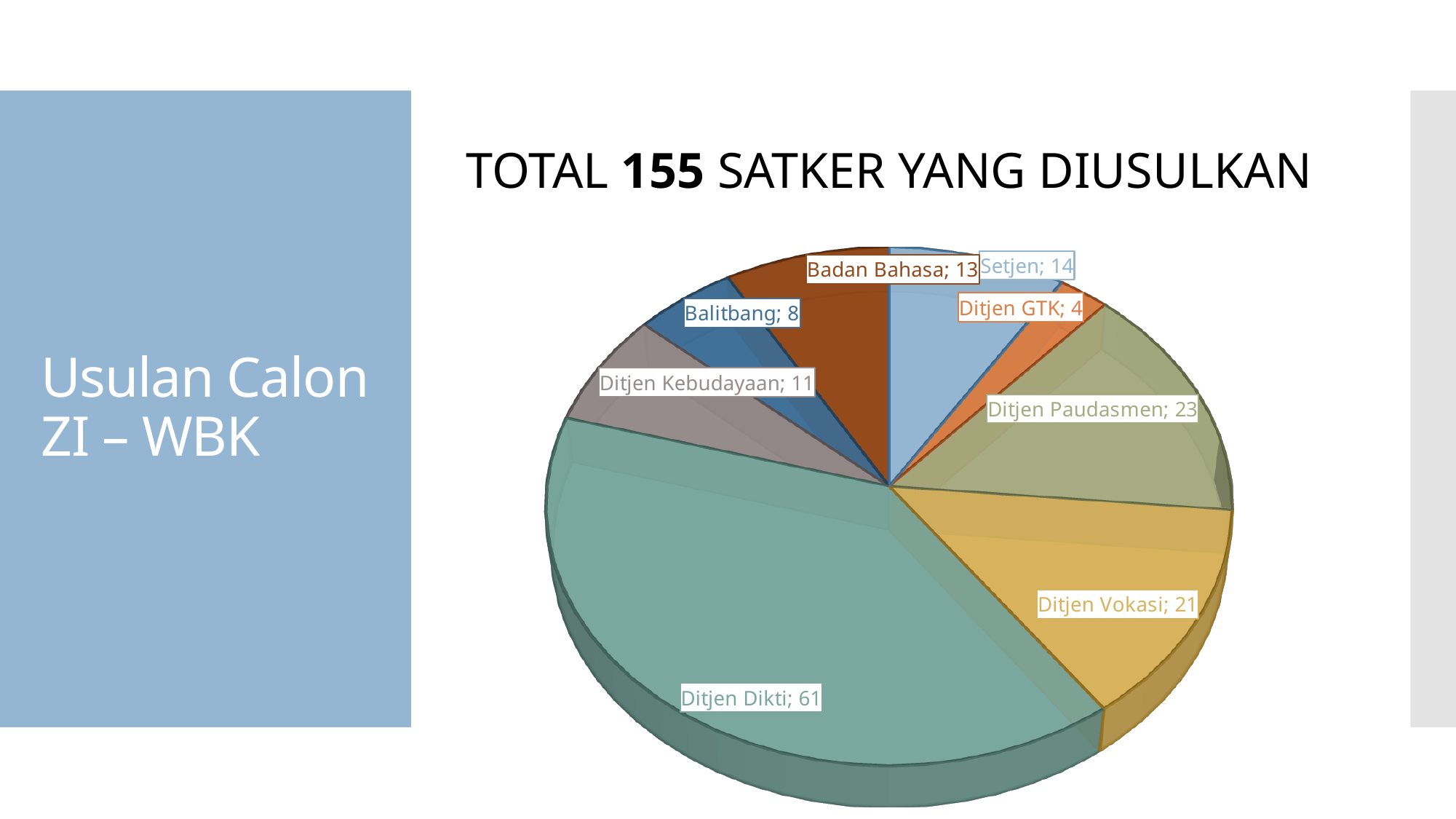
What is the value for Ditjen Dikti? 61 What is the difference between the values for Ditjen Paudasmen and Ditjen Vokasi? 2 What total number of satker does the chart title state? 155 Which is larger, the value for Ditjen Kebudayaan or the value for Balitbang? Ditjen Kebudayaan Which category has the smallest slice? Ditjen GTK What kind of chart is shown on the slide? pie chart What is the value for Ditjen Paudasmen? 23 What is the value for Balitbang? 8 What is the value for Ditjen GTK? 4 What is the difference between the values for Setjen and Badan Bahasa? 1 Which category has the largest slice? Ditjen Dikti How many slices does the pie chart have? 8